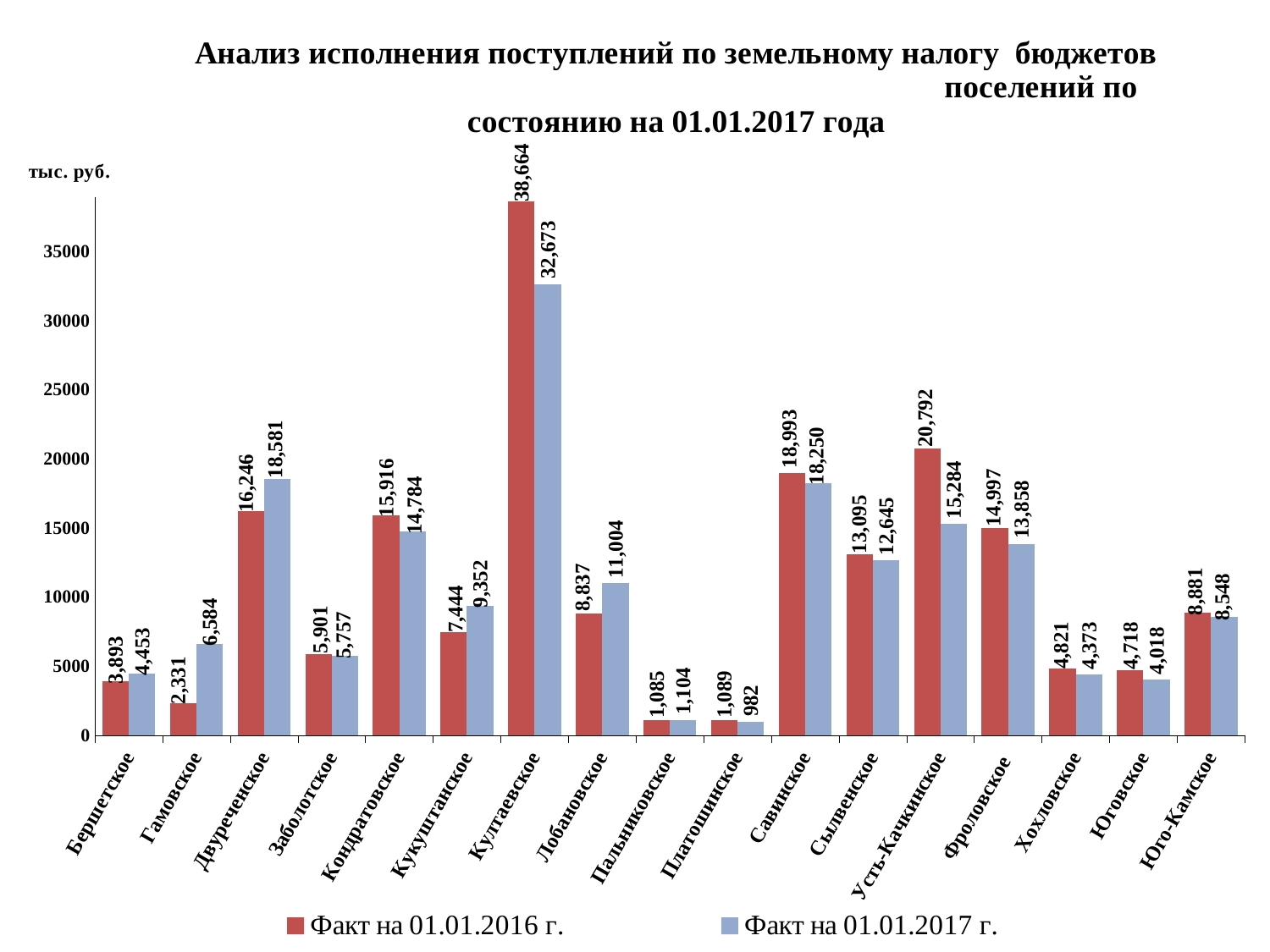
Which category has the highest value in the series Факт на 01.01.2017 г.? Култаевское What kind of chart is shown on the slide? Bar chart Is the value for Савинское in the series Факт на 01.01.2016 г. greater or less than 15000? greater What is the difference between the Факт на 01.01.2016 г. and Факт на 01.01.2017 г. values for Култаевское? 5,991 How many series does the legend list? 2 What is the value for Гамовское in the series Факт на 01.01.2017 г.? 6,584 How many categories (settlements) are shown on the x axis? 17 For Лобановское, which series has the larger value: Факт на 01.01.2016 г. or Факт на 01.01.2017 г.? Факт на 01.01.2017 г. What is the value for Усть-Качкинское in the series Факт на 01.01.2016 г.? 20,792 Which category has the lowest value in the series Факт на 01.01.2017 г.? Платошинское What is the difference between the Факт на 01.01.2017 г. and Факт на 01.01.2016 г. values for Гамовское? 4,253 What is the value for Култаевское in the series Факт на 01.01.2016 г.? 38,664